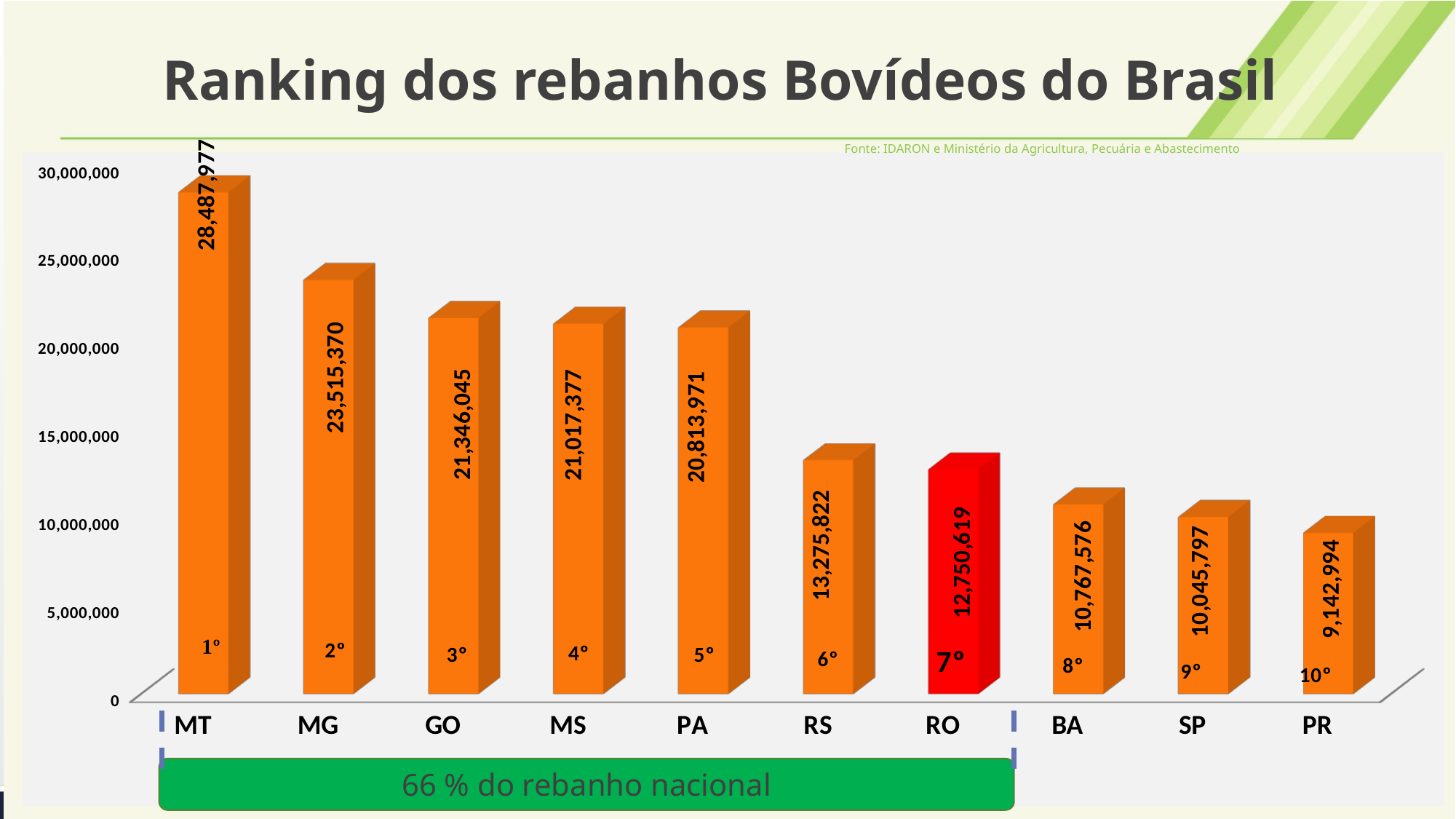
What is the value shown for MT? 28,487,977 How many states are shown in the chart? 10 What kind of chart is shown on the slide? bar chart What is the difference between the values for RS and RO? 525,203 Which state has the lowest value? PR What is the value shown for RO? 12,750,619 Which state's bar is coloured red instead of orange? RO Which state has the highest value? MT What is the value shown for PR? 9,142,994 Which has a larger value, GO or MS? GO What is the difference between the values for MT and MG? 4,972,607 Is the value for PA greater or less than 20,000,000? greater